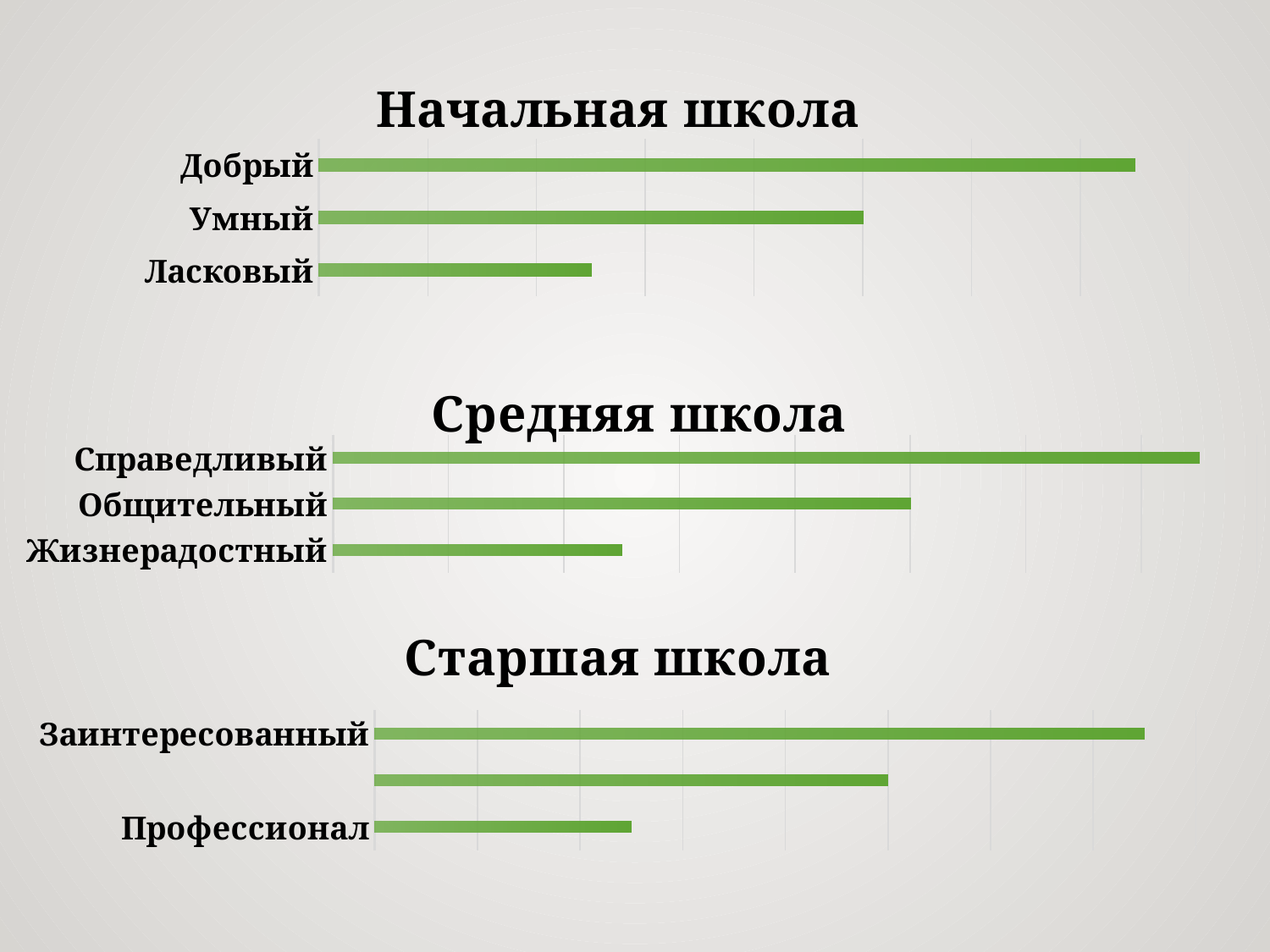
In the chart titled "Начальная школа", which category has the longest bar? Добрый In the chart titled "Средняя школа", which category has the longest bar? Справедливый In the chart titled "Начальная школа", which bar is longer: Умный or Ласковый? Умный What is the title of the top chart on the slide? Начальная школа How many bars are plotted in the chart titled "Старшая школа"? 3 What kind of chart is the chart titled "Средняя школа"? Bar chart In the chart titled "Старшая школа", which bar is longer: Заинтересованный or Профессионал? Заинтересованный How many categories are shown in the chart titled "Начальная школа"? 3 In the chart titled "Средняя школа", which category has the shortest bar? Жизнерадостный In the chart titled "Начальная школа", which category has the shortest bar? Ласковый In the chart titled "Средняя школа", which bar is longer: Общительный or Жизнерадостный? Общительный In the chart titled "Старшая школа", which labelled category has the longest bar? Заинтересованный